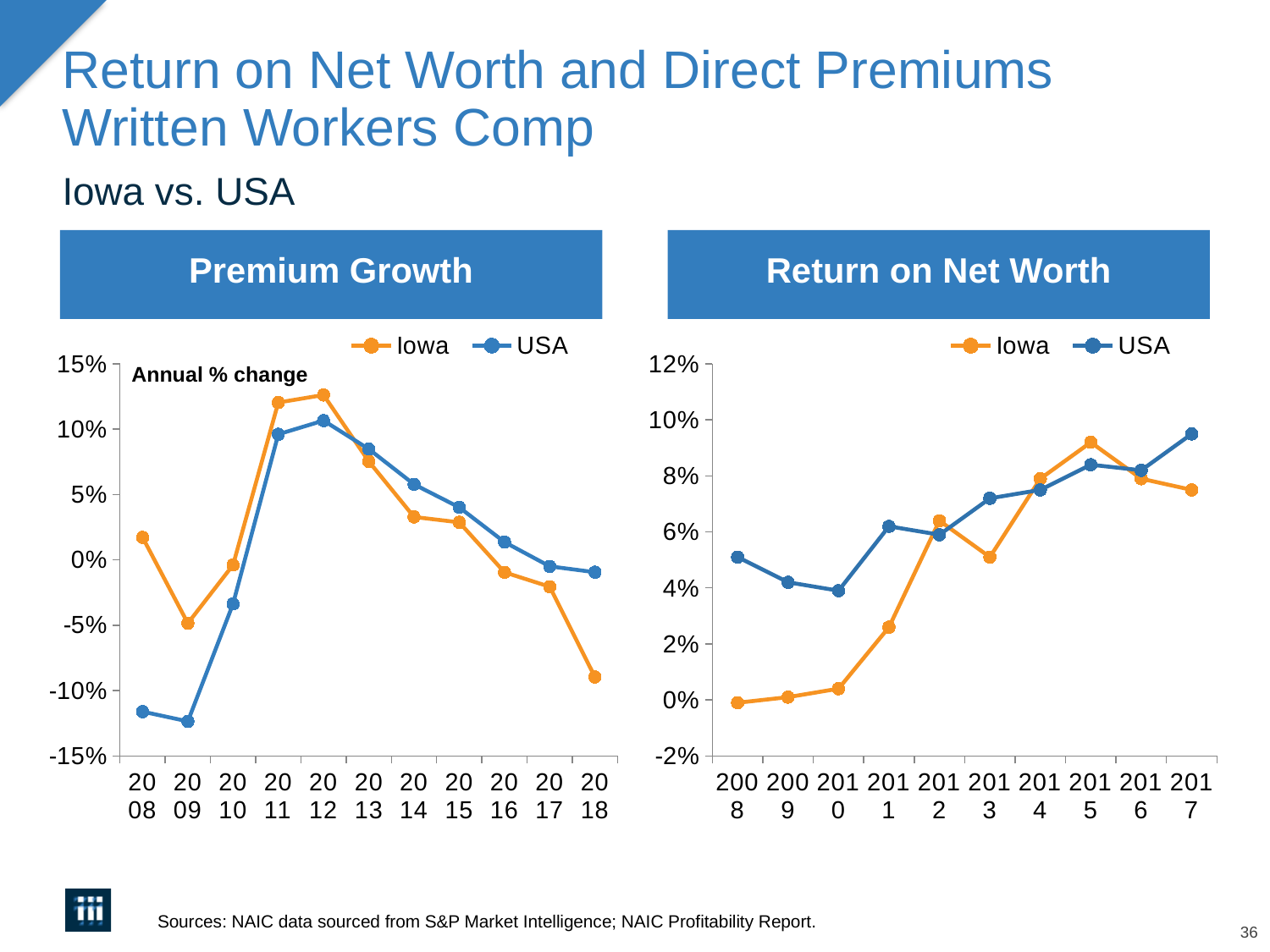
In the Return on Net Worth chart, which year has the highest value for USA? 2017 In the Premium Growth chart, which year has the lowest value for Iowa? 2018 What annotation text appears inside the plot area of the Premium Growth chart? Annual % change In the Premium Growth chart, which year has the highest value for USA? 2012 In the Premium Growth chart, which series has the larger value in 2009, Iowa or USA? Iowa How many years are plotted on the x axis of the Return on Net Worth chart? 10 How many series does the legend of the Premium Growth chart list? 2 In the Return on Net Worth chart, is the value for Iowa in 2008 greater or less than 2%? less In the Premium Growth chart, is the value for Iowa in 2018 greater or less than -5%? less How many years are plotted on the x axis of the Premium Growth chart? 11 What type of chart is the Premium Growth chart? line chart In the Return on Net Worth chart, which series has the larger value in 2010, Iowa or USA? USA